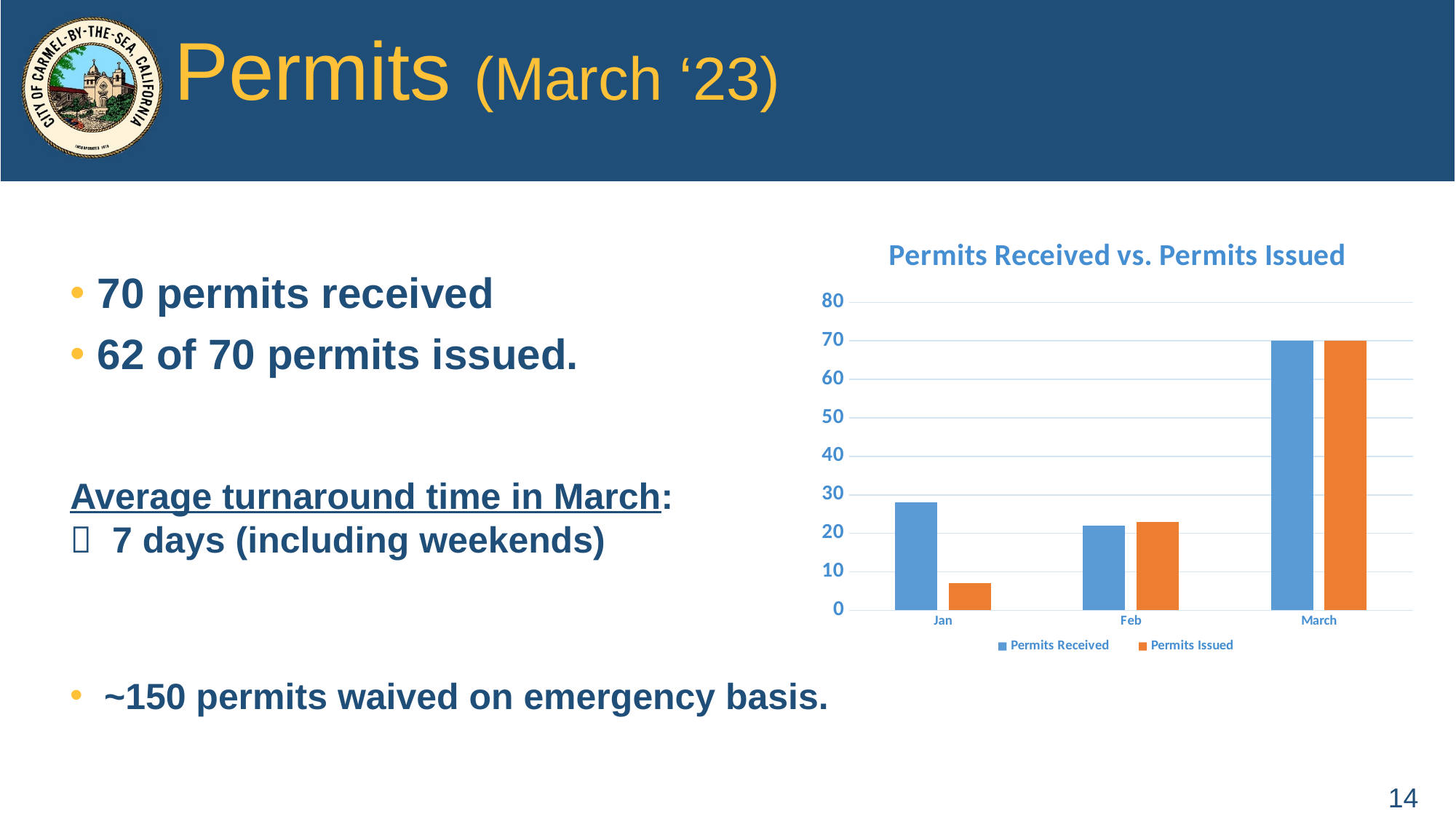
Is the value for Permits Issued in March greater or less than 60? greater Is the value for Permits Issued in Jan greater or less than 10? less Which month has the highest value for Permits Received? March In Jan, which is larger: Permits Received or Permits Issued? Permits Received How many months are shown on the x axis of the chart? 3 Is the value for Permits Received in Feb greater or less than 30? less How many series does the chart legend list? 2 What is the title of the chart? Permits Received vs. Permits Issued Which month has the lowest value for Permits Issued? Jan Do the values for Permits Issued rise or fall from Jan to March? rise What kind of chart is shown on the slide? bar chart